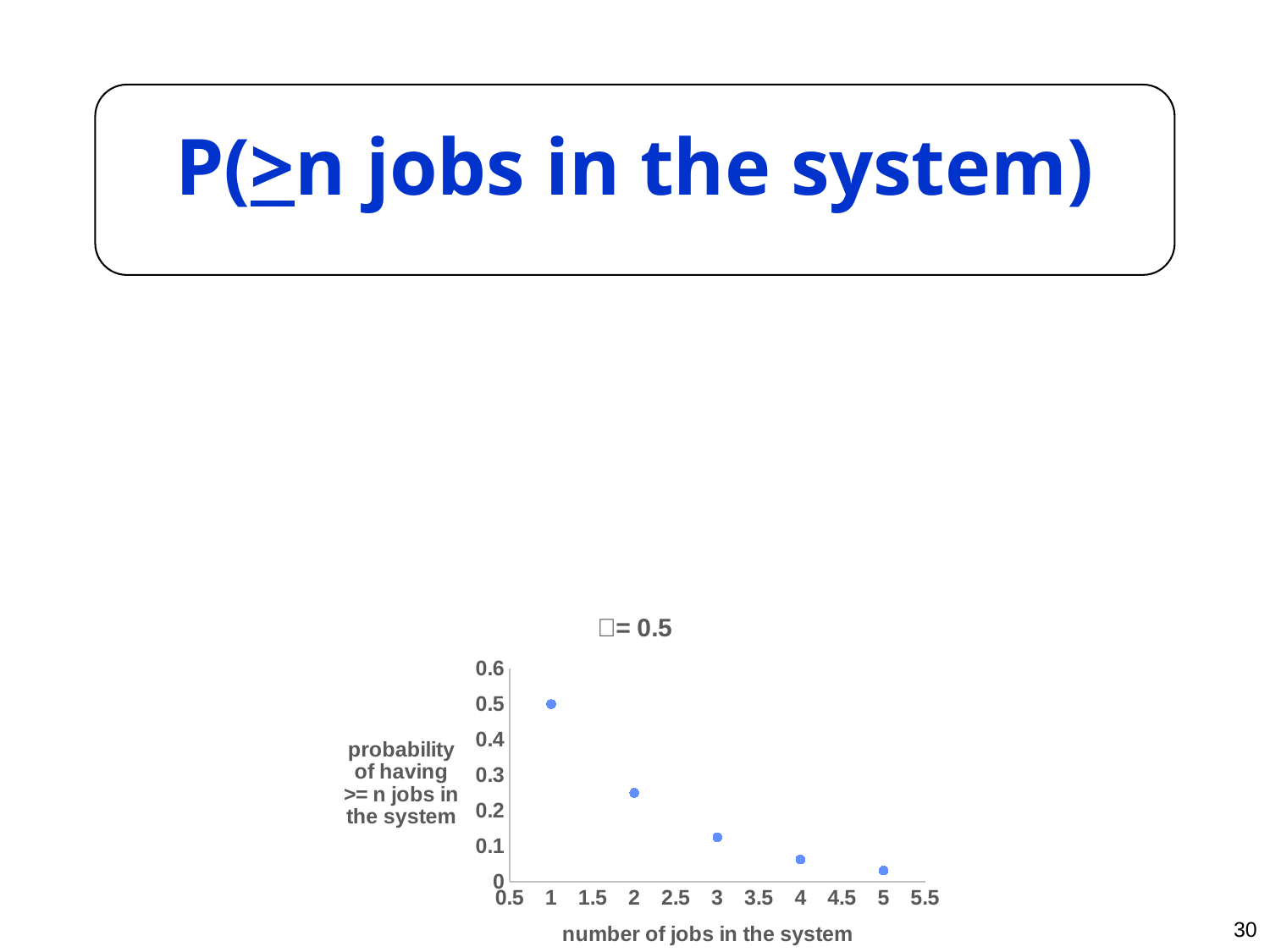
Is the value for 4 jobs in the system greater or less than 0.1? less What is the label of the x axis? number of jobs in the system Is the value for 2 jobs in the system greater or less than 0.2? greater What kind of chart is shown on the slide? scatter plot Which number of jobs has the highest plotted probability? 1 How many data points are plotted in the chart? 5 Is the value for 3 jobs in the system greater or less than 0.2? less What numeric value appears in the chart title? 0.5 Which number of jobs has the lowest plotted probability? 5 What is the probability value plotted for 1 job in the system? 0.5 Which is larger: the value for 2 jobs or the value for 4 jobs in the system? 2 jobs Do the plotted probabilities rise or fall as the number of jobs in the system increases? fall